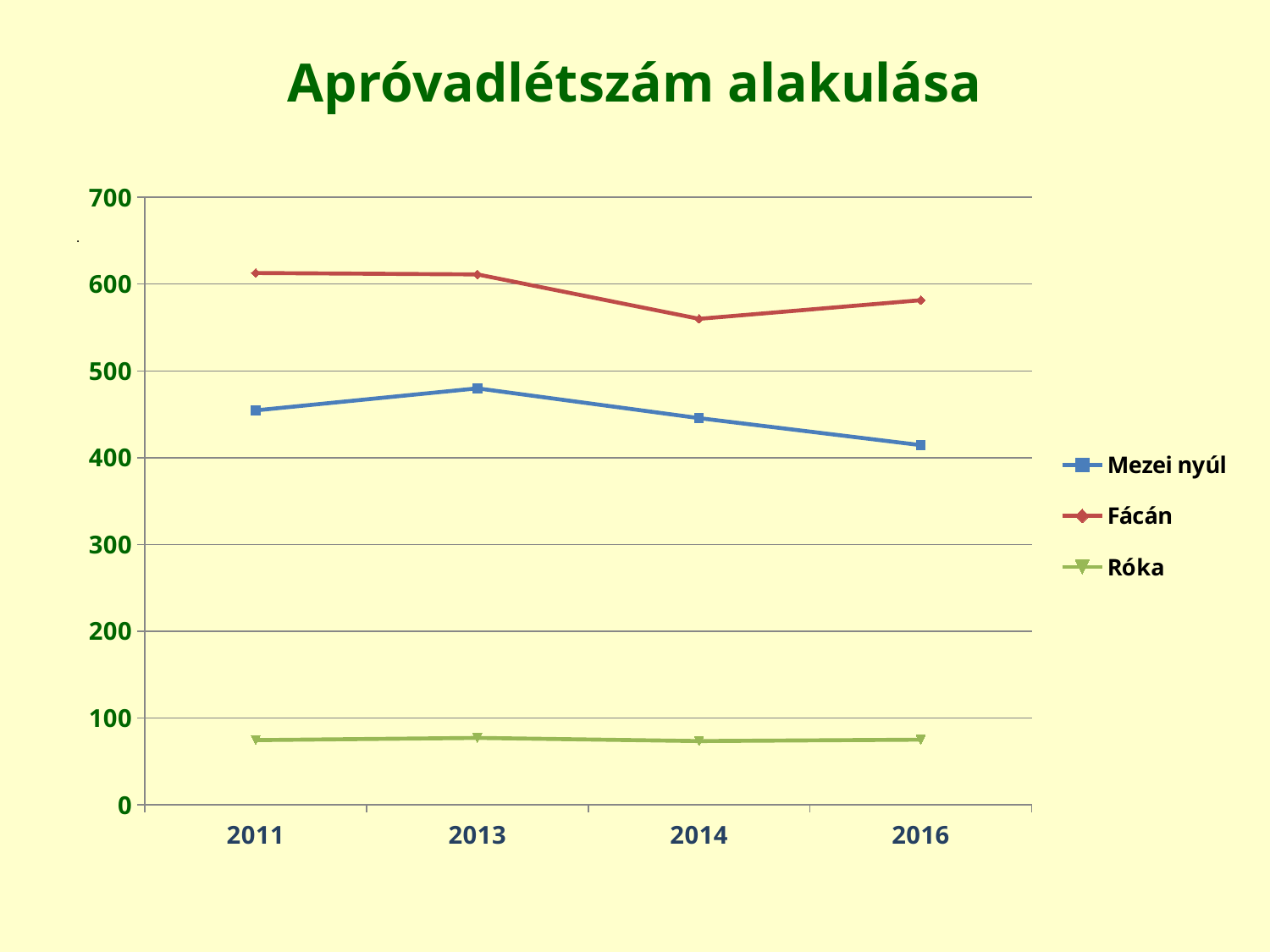
In which year is the value for Mezei nyúl lowest? 2016 In which year is the value for Fácán lowest? 2014 Which series has the lowest values across all years? Róka Does the value for Mezei nyúl rise or fall from 2013 to 2016? fall What is the title of the chart? Apróvadlétszám alakulása Is the value for Fácán in 2014 greater or less than 600? less In which year is the value for Mezei nyúl highest? 2013 How many series does the legend list? 3 What kind of chart is shown on the slide? line chart Is the value for Mezei nyúl in 2016 greater or less than 400? greater How many years are plotted along the x axis? 4 Which series has the highest values across all years? Fácán